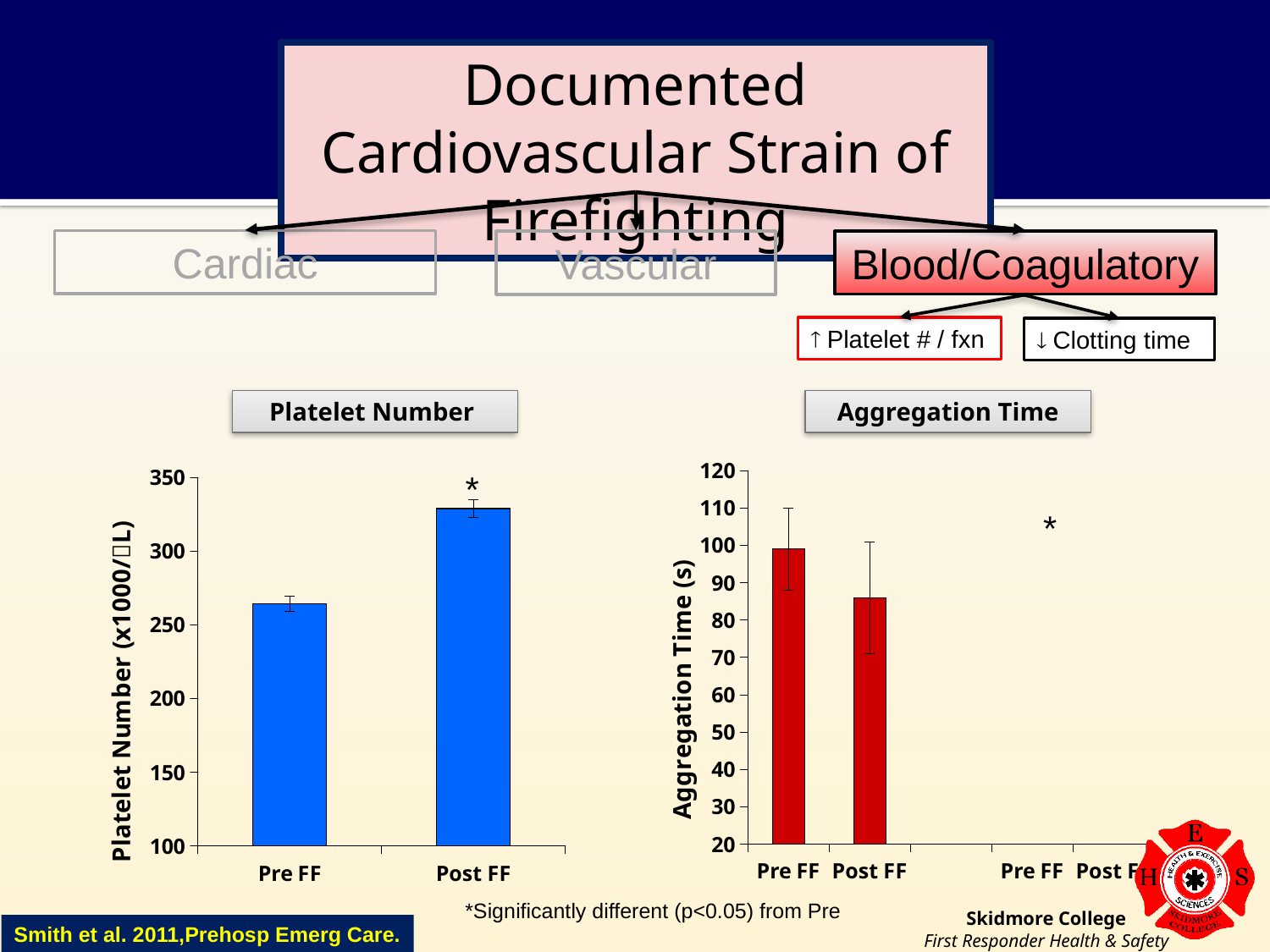
In the Aggregation Time chart, is the value for Pre FF greater or less than 90? greater In the Platelet Number chart, is the value for Pre FF greater or less than 300? less What kind of chart is the Platelet Number chart? bar chart In the Platelet Number chart, which category has the lowest value? Pre FF In the Aggregation Time chart, which category has the higher value, Pre FF or Post FF? Pre FF What kind of chart is the Aggregation Time chart? bar chart In the Platelet Number chart, which category has the higher value, Pre FF or Post FF? Post FF In the Aggregation Time chart, is the value for Post FF greater or less than 90? less How many categories are shown on the x axis of the Platelet Number chart? 2 What is the y-axis title of the Aggregation Time chart? Aggregation Time (s)